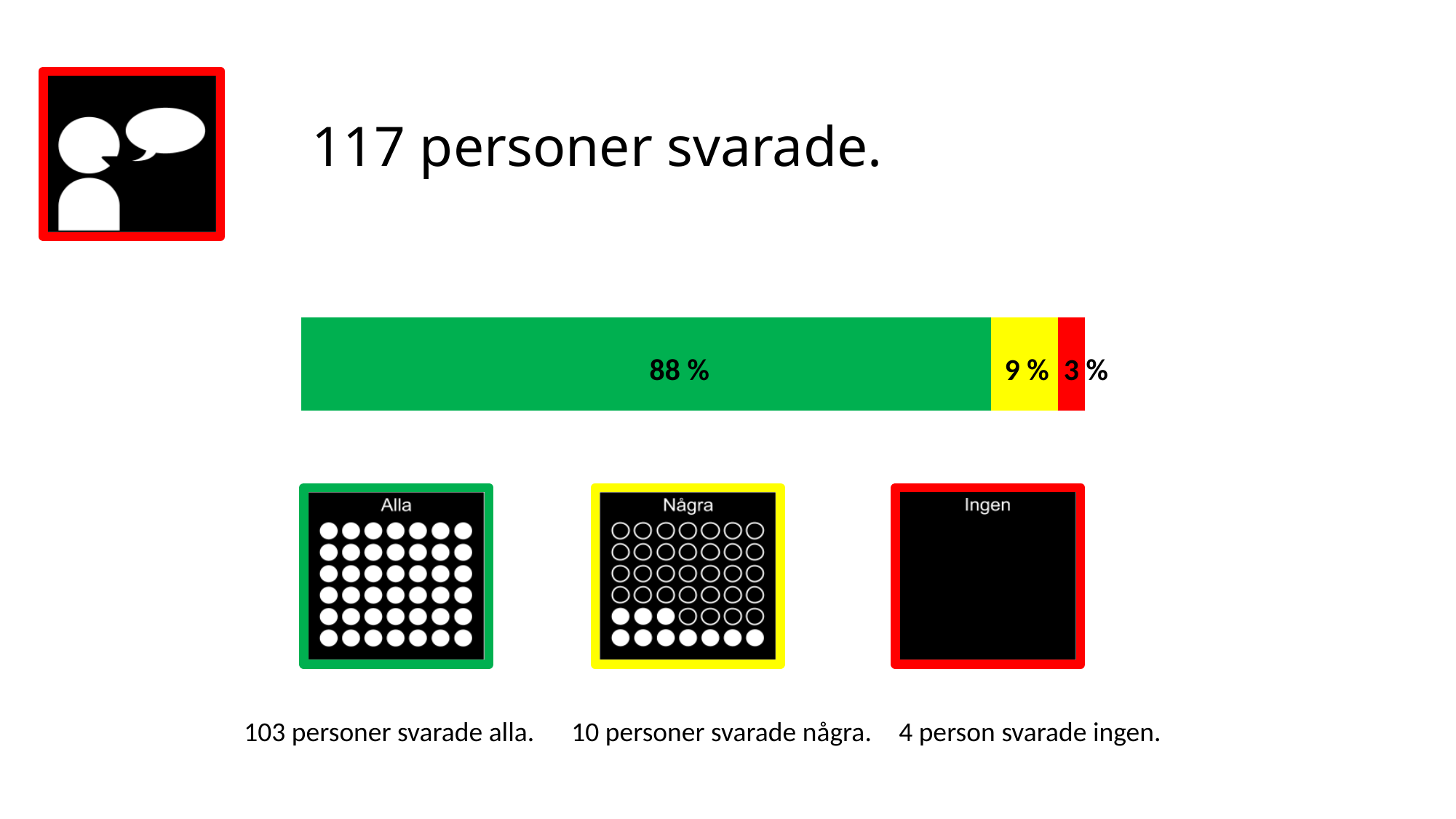
Which is larger, the yellow segment or the red segment of the bar? the yellow segment (9 %) What percentage is shown on the red segment of the bar? 3 % Which segment of the bar has the smallest share? 3 % (red) What is the difference between the yellow segment and the red segment of the bar? 6 % Which segment of the bar has the largest share? 88 % (green) What percentage is shown on the yellow segment of the bar? 9 % What is the difference between the green segment and the yellow segment of the bar? 79 % What is the total of all segments in the stacked bar? 100 % What percentage is shown on the green segment of the bar? 88 % What kind of chart is shown on the slide? a stacked bar chart What colour is the segment labelled 88 %? green How many segments does the stacked bar have? 3